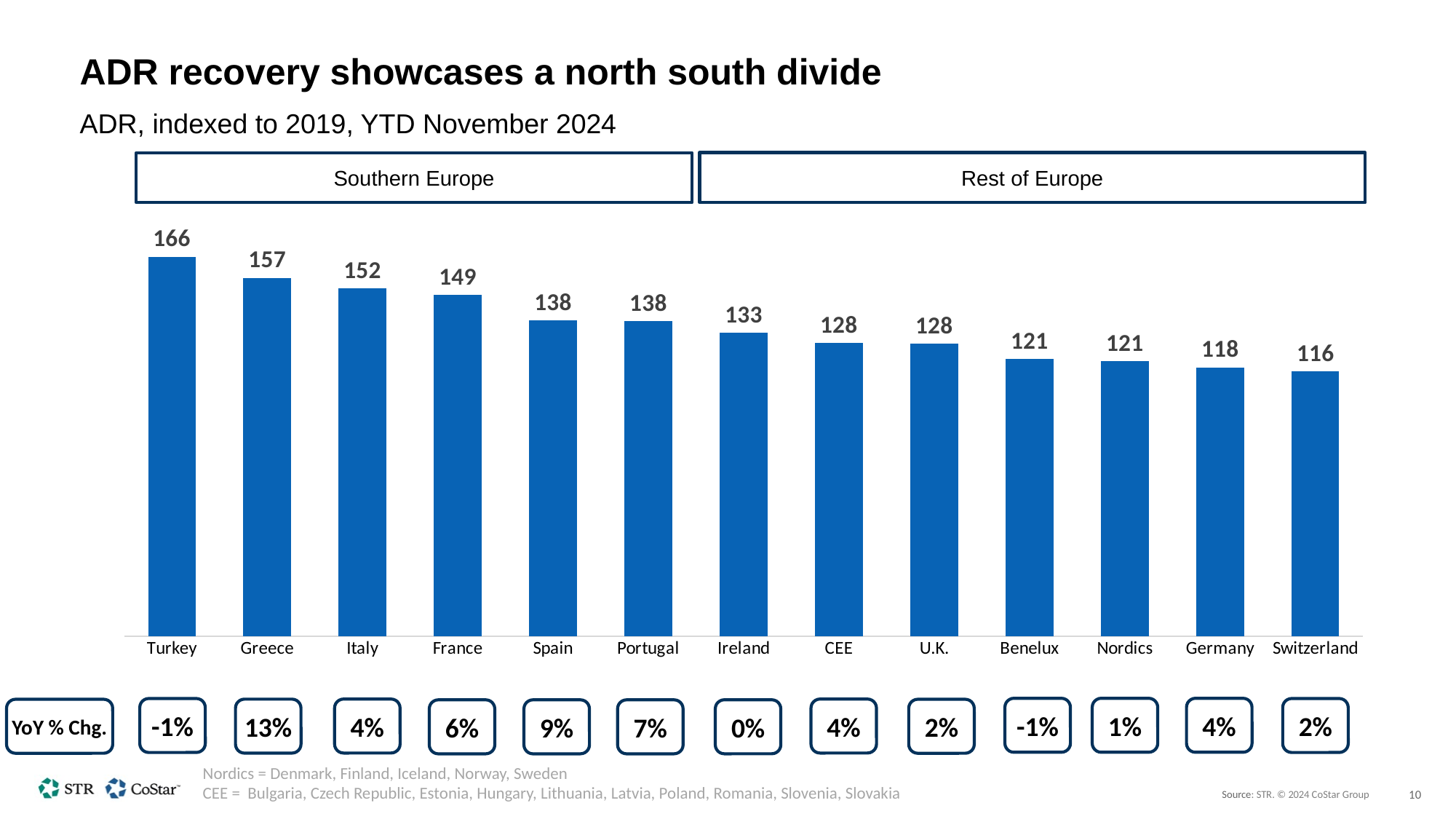
Do the ADR index values rise or fall from left to right along the x axis? Fall What is the difference between the ADR index values for Greece and Germany? 39 What is the ADR index value for Turkey? 166 Which has a higher ADR index value, Italy or Benelux? Italy How many categories are shown on the x axis of the chart? 13 What is the YoY % change shown for Greece? 13% What is the YoY % change shown for Ireland? 0% Which category has the highest ADR index value? Turkey Which category has the lowest ADR index value? Switzerland What kind of chart is shown on the slide? Bar chart What is the ADR index value for Ireland? 133 What are the two group labels shown above the chart? Southern Europe and Rest of Europe